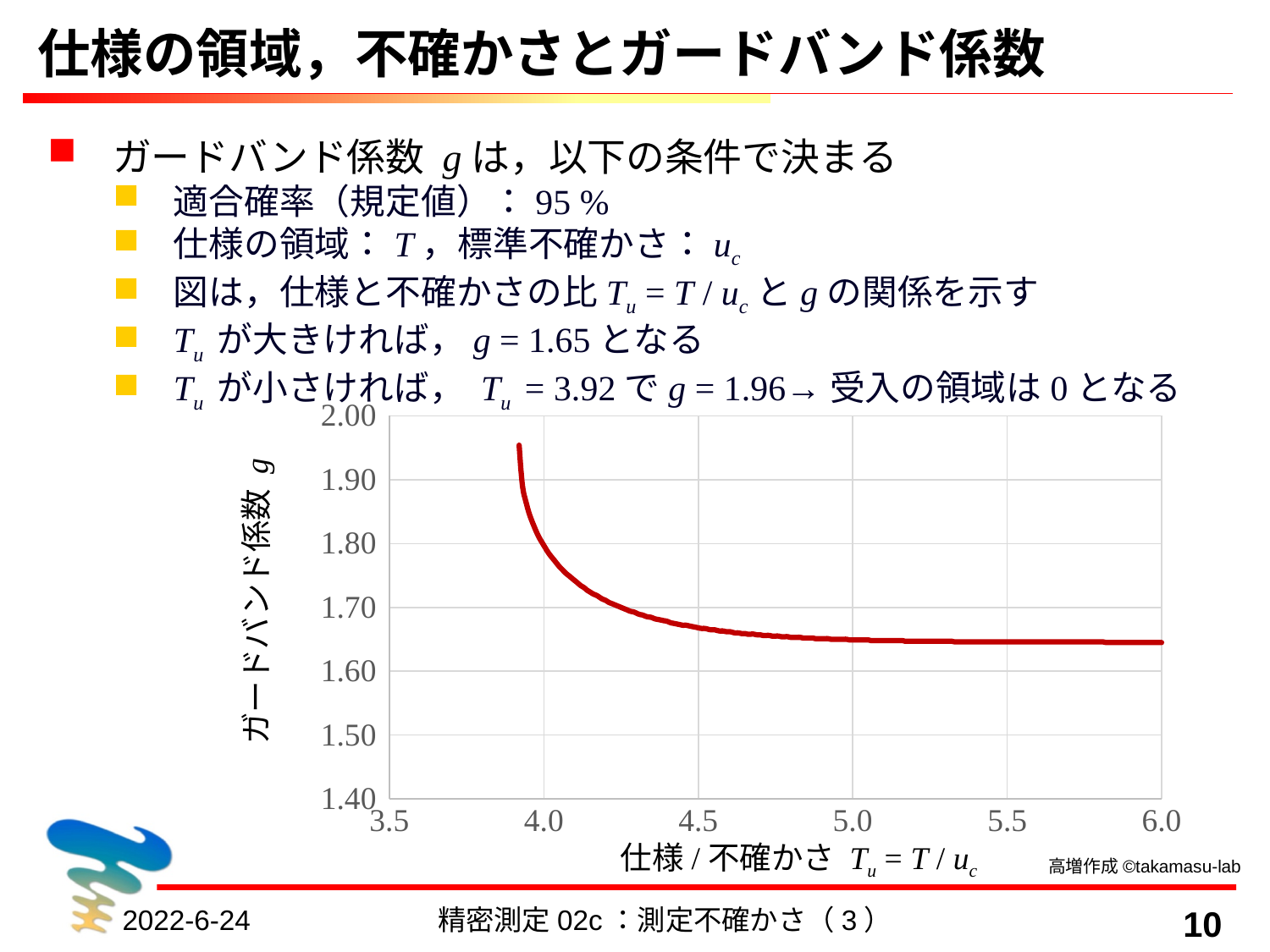
Is the value of g at T_u = 4.5 greater or less than 1.80? less According to the slide, what value does g approach when T_u is large? 1.65 Is the value of g at T_u = 6.0 greater or less than 1.60? greater What kind of chart is shown on the slide? line chart At which end of the x axis does the curve reach its highest value of g? the left end (smallest T_u) Is the value of g at T_u = 5.5 greater or less than 1.70? less As T_u increases along the x axis, does the guard band factor g rise or fall? fall What is the label of the y axis of the chart? ガードバンド係数 g What range does the x axis of the chart cover? 3.5 to 6.0 According to the slide, what is g when T_u = 3.92? 1.96